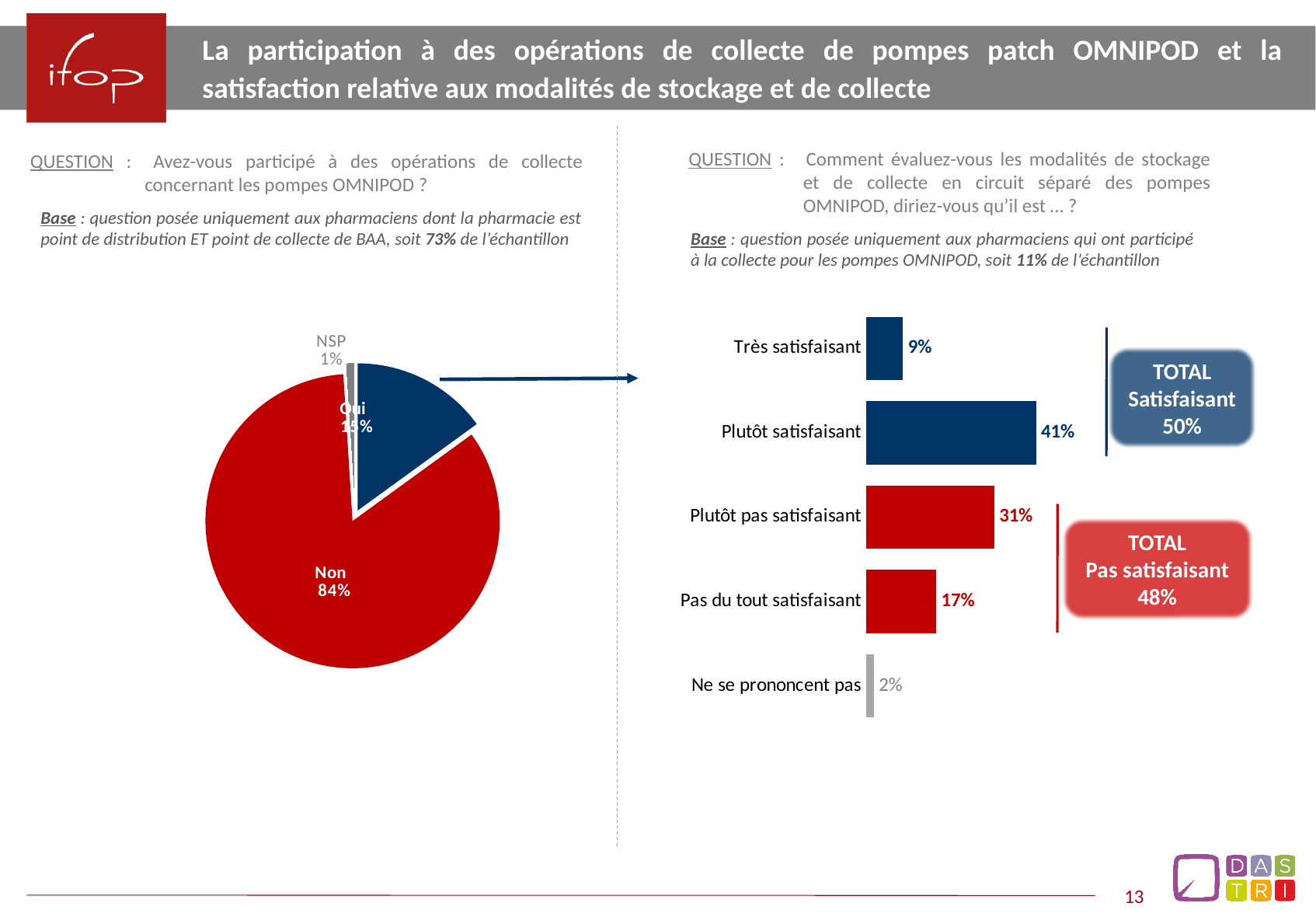
In the pie chart on the left, what share of respondents answered "NSP"? 1% In the bar chart on the right, what is the value for "Pas du tout satisfaisant"? 17% In the pie chart on the left, what share of respondents answered "Non"? 84% In the pie chart on the left, which category has the smallest slice? NSP In the bar chart on the right, what is the value for "Plutôt satisfaisant"? 41% What kind of chart is shown on the left side of the slide? Pie chart In the bar chart on the right, which category has the lowest value? Ne se prononcent pas In the bar chart on the right, which category has the highest value? Plutôt satisfaisant In the pie chart on the left, which category has the largest slice? Non In the bar chart on the right, what is the difference between "Plutôt satisfaisant" and "Plutôt pas satisfaisant"? 10 percentage points In the bar chart on the right, what is the value shown in the "TOTAL Satisfaisant" box? 50% In the bar chart on the right, how many categories are shown? 5